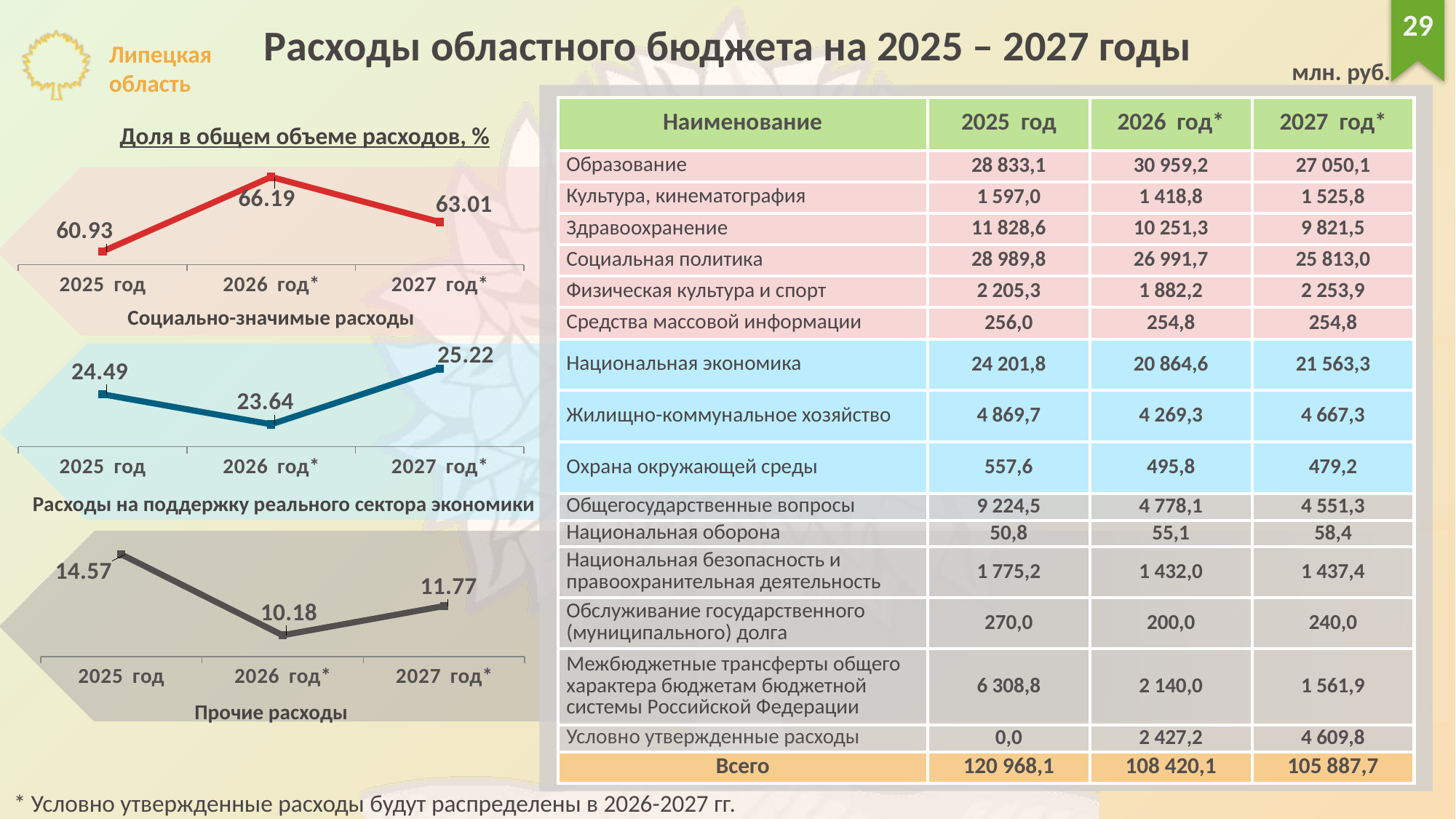
How many data points are plotted in the chart titled "Прочие расходы"? 3 What kind of chart is used for "Социально-значимые расходы"? Line chart In the chart titled "Социально-значимые расходы", which year has the highest value? 2026 год* In the chart titled "Социально-значимые расходы", what is the value for 2026 год*? 66.19 In the chart titled "Расходы на поддержку реального сектора экономики", which year has the lowest value? 2026 год* In the chart titled "Прочие расходы", what is the difference between the values for 2025 год and 2027 год*? 2.80 In the chart titled "Прочие расходы", what is the value for 2025 год? 14.57 In the chart titled "Расходы на поддержку реального сектора экономики", which is larger: the value for 2025 год or the value for 2027 год*? 2027 год* In the chart titled "Расходы на поддержку реального сектора экономики", what is the value for 2027 год*? 25.22 In the chart titled "Социально-значимые расходы", what is the difference between the values for 2026 год* and 2025 год? 5.26 In the chart titled "Прочие расходы", does the value rise or fall from 2025 год to 2026 год*? Fall In the chart titled "Прочие расходы", which year has the lowest value? 2026 год*